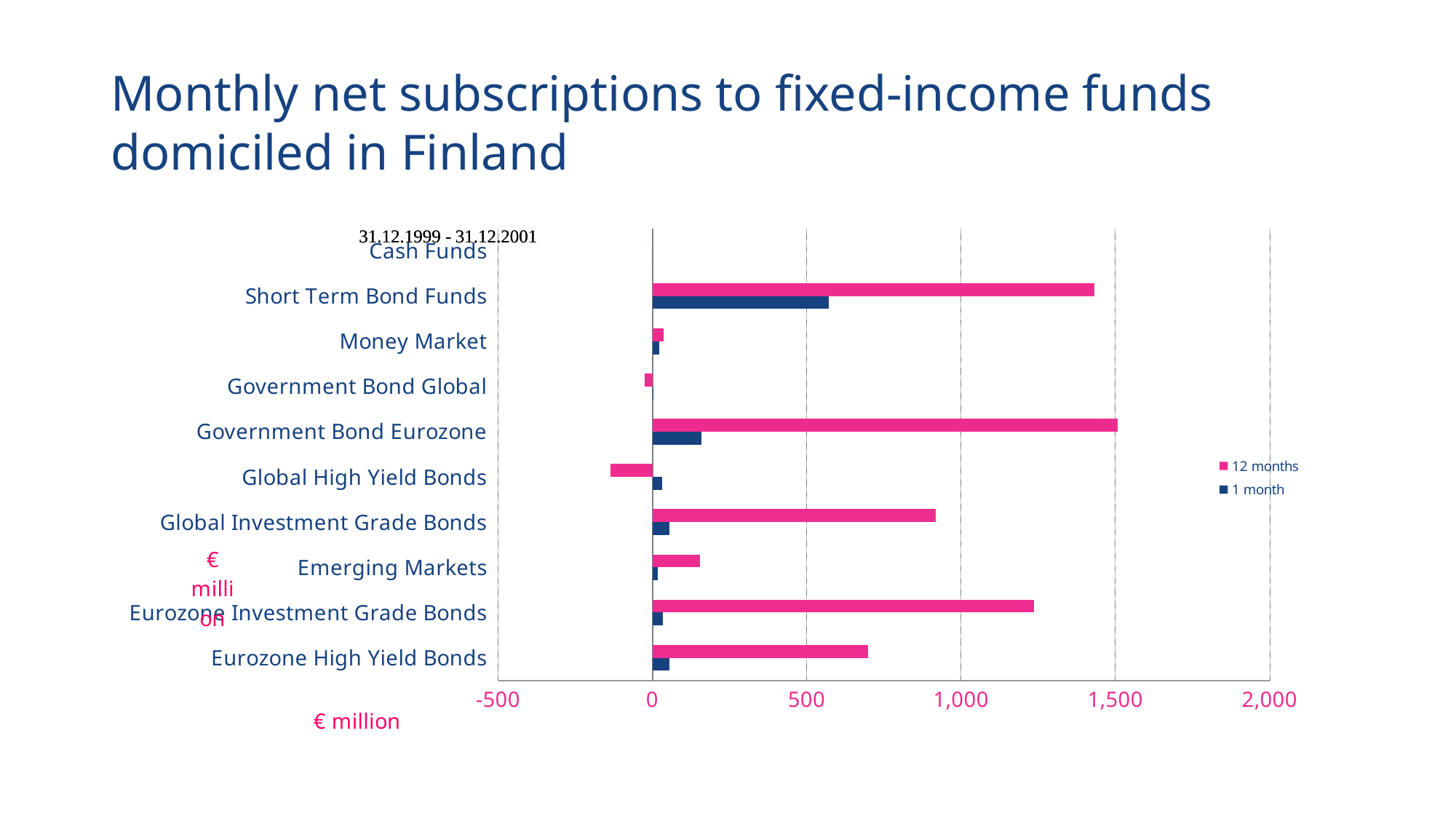
Is the 1 month value for Short Term Bond Funds greater or less than 500? greater Is the 12 months value for Global Investment Grade Bonds greater or less than 1,000? less How many fund categories are shown on the y axis? 10 Which category has the highest 12 months value? Government Bond Eurozone Is the 12 months value for Global High Yield Bonds greater or less than 0? less What unit is shown on the x axis of the chart? € million Which category has the lowest 12 months value? Global High Yield Bonds Which has the larger 12 months value, Short Term Bond Funds or Eurozone Investment Grade Bonds? Short Term Bond Funds How many series does the legend list? 2 Which category has the highest 1 month value? Short Term Bond Funds What kind of chart is shown on the slide? bar chart